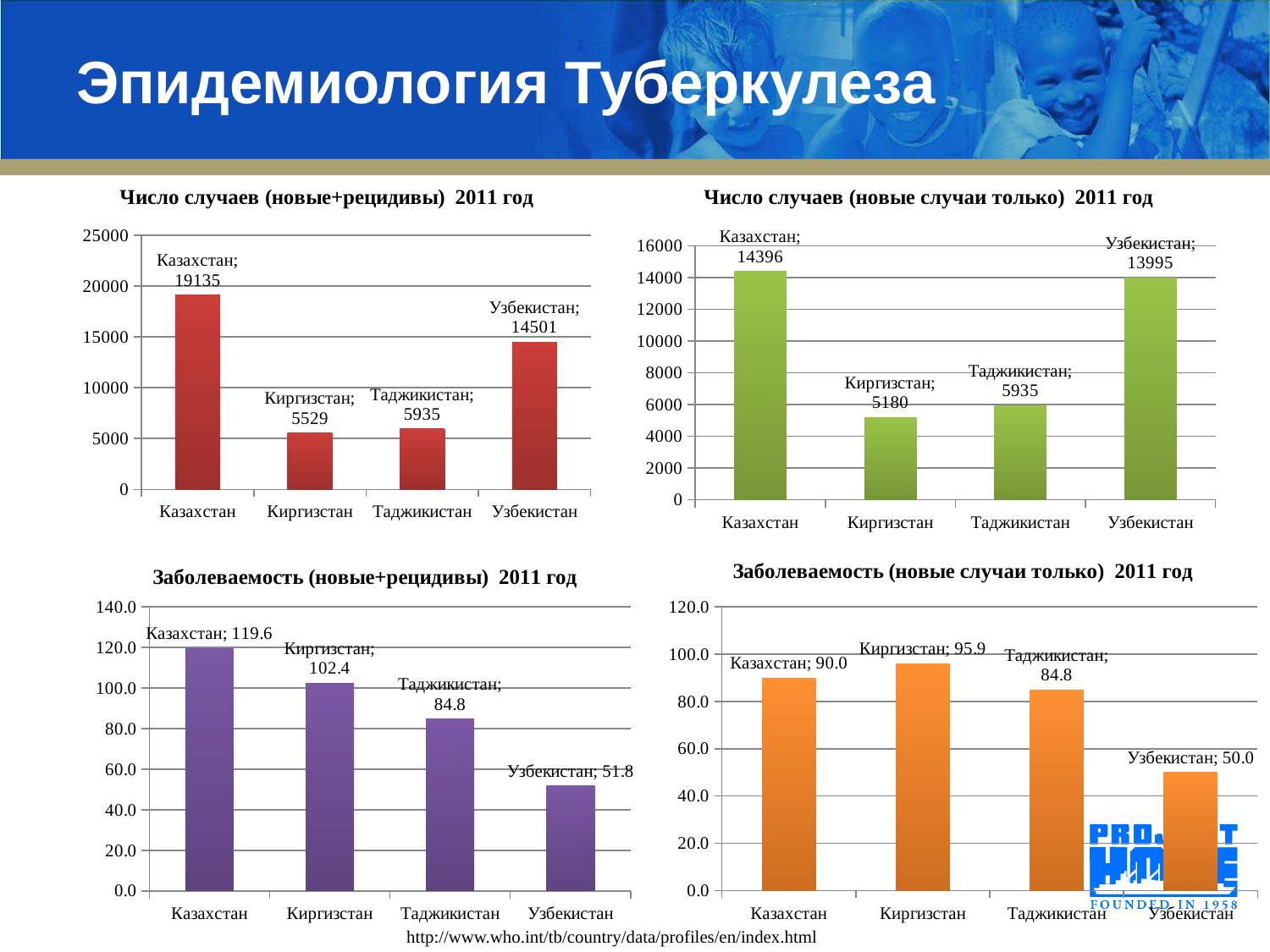
In the chart titled "Заболеваемость (новые+рецидивы) 2011 год", what is the difference between the values for Казахстан and Киргизстан? 17.2 What kind of chart is the chart titled "Заболеваемость (новые+рецидивы) 2011 год"? bar chart How many countries are shown in the chart titled "Число случаев (новые случаи только) 2011 год"? 4 In the chart titled "Число случаев (новые случаи только) 2011 год", what is the difference between the values for Казахстан and Узбекистан? 401 In the chart titled "Число случаев (новые+рецидивы) 2011 год", which country has the lowest value? Киргизстан In the chart titled "Число случаев (новые случаи только) 2011 год", what is the value for Киргизстан? 5180 In the chart titled "Заболеваемость (новые случаи только) 2011 год", which country has the highest value? Киргизстан In the chart titled "Число случаев (новые+рецидивы) 2011 год", which is larger: the value for Таджикистан or the value for Киргизстан? Таджикистан In the chart titled "Заболеваемость (новые+рецидивы) 2011 год", what is the value for Узбекистан? 51.8 In the chart titled "Число случаев (новые+рецидивы) 2011 год", what is the value for Казахстан? 19135 In the chart titled "Заболеваемость (новые+рецидивы) 2011 год", do the values rise or fall from Казахстан to Узбекистан along the x axis? fall In the chart titled "Заболеваемость (новые случаи только) 2011 год", is the value for Узбекистан greater or less than 60.0? less